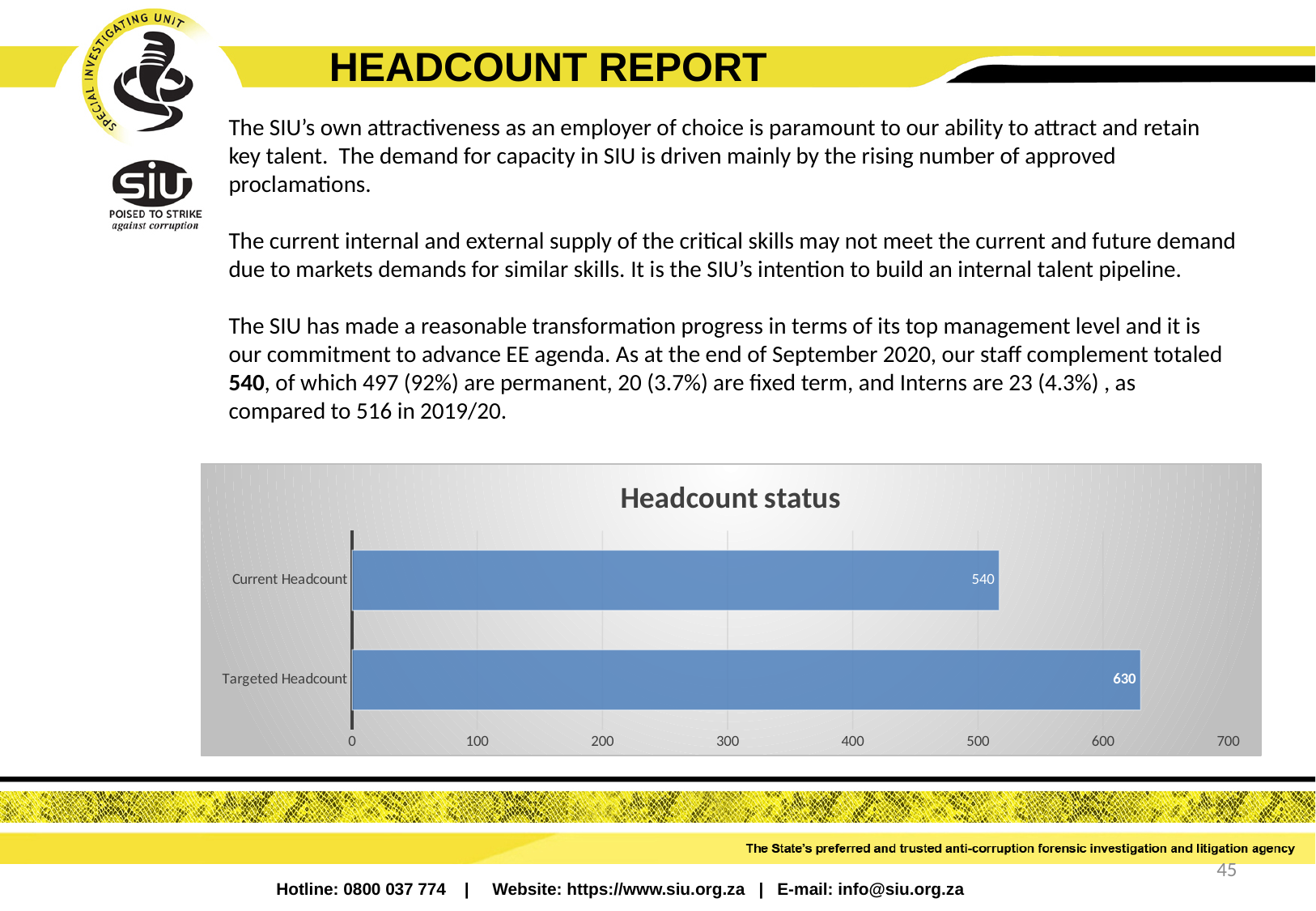
Is the value for Current Headcount greater or less than 500 in the Headcount status chart? greater What is the value for Current Headcount in the Headcount status chart? 540 Is the value for Targeted Headcount greater or less than 700 in the Headcount status chart? less What is the title of the chart on the slide? Headcount status What is the value for Targeted Headcount in the Headcount status chart? 630 Which is larger in the Headcount status chart, Current Headcount or Targeted Headcount? Targeted Headcount What kind of chart is the Headcount status chart? Bar chart Which category has the lowest value in the Headcount status chart? Current Headcount How many categories are shown in the Headcount status chart? 2 What is the maximum value shown on the x axis of the Headcount status chart? 700 Which category has the highest value in the Headcount status chart? Targeted Headcount What is the difference between the Targeted Headcount and the Current Headcount in the Headcount status chart? 90